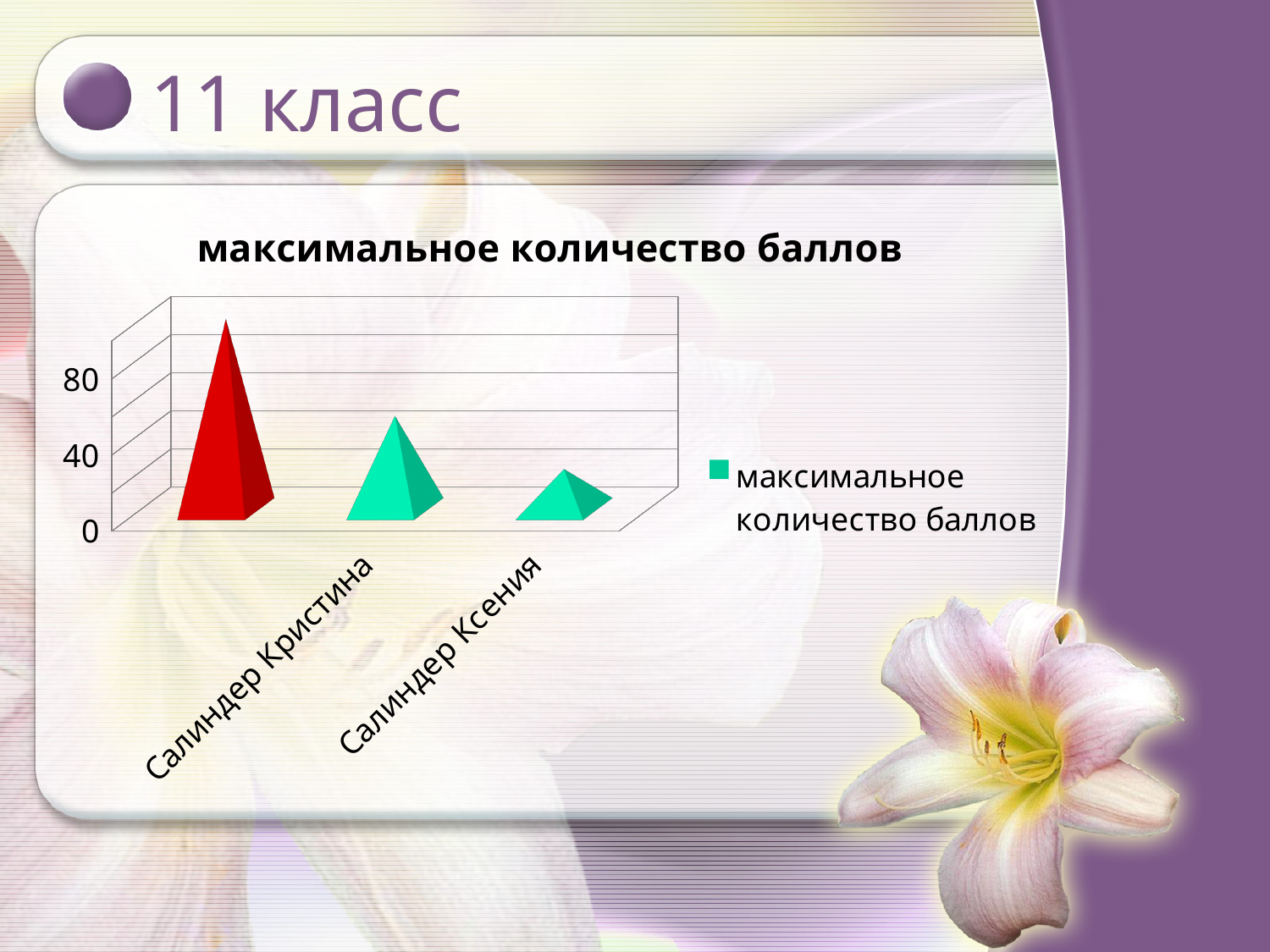
Is the value for Салиндер Ксения greater or less than 80? less Which is larger, the value for Салиндер Кристина or the value for Салиндер Ксения? Салиндер Кристина What kind of chart is shown on the slide? bar chart Do the values rise or fall from left to right along the x axis? fall What is the title of the chart? максимальное количество баллов Is the value for Салиндер Ксения greater or less than 40? less What is the legend entry of the chart? максимальное количество баллов How many series does the legend list? 1 Is the value for Салиндер Кристина greater or less than 80? less How many bars are plotted in the chart? 3